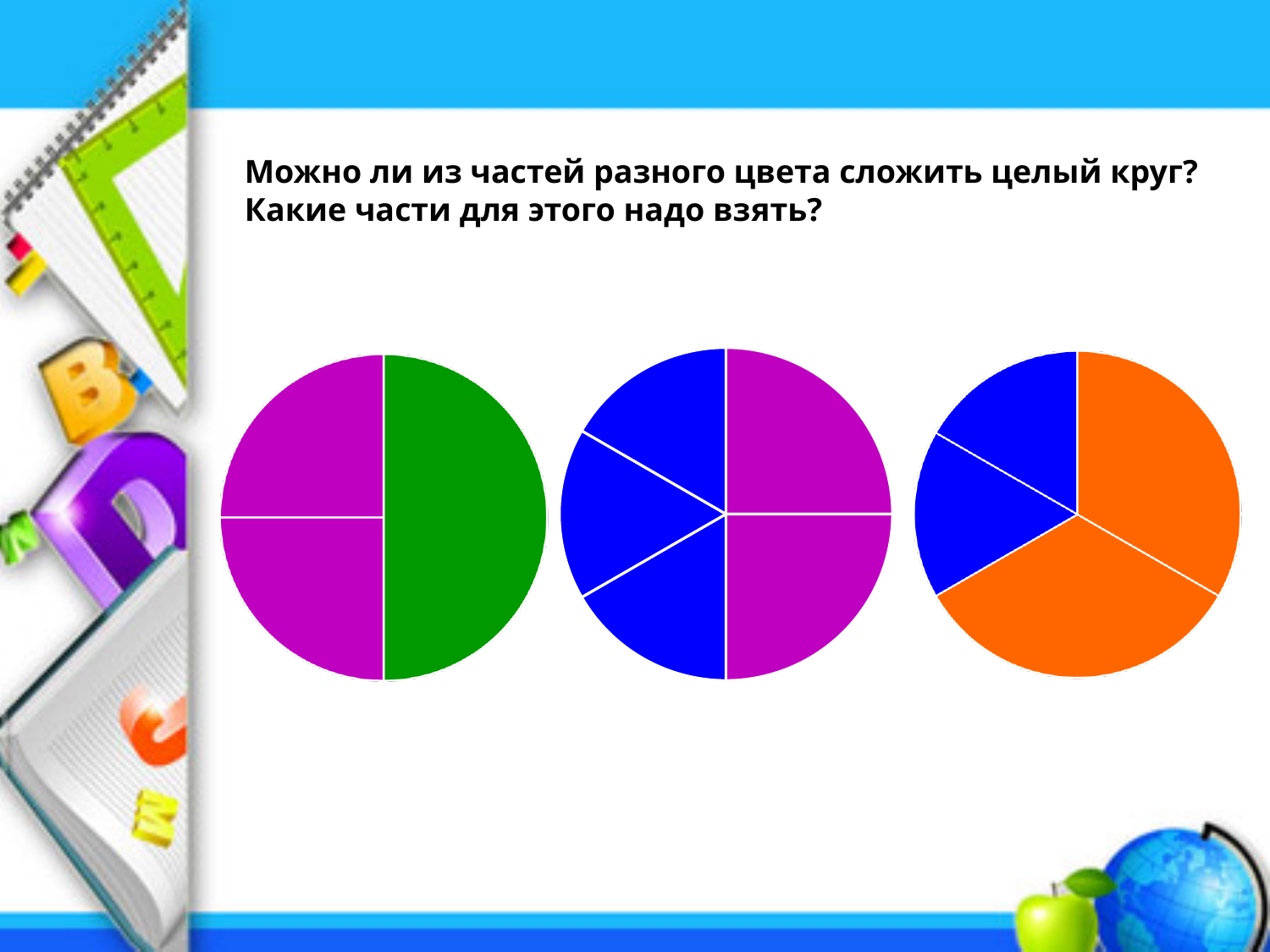
What two colours are used in the leftmost chart? purple and green In the middle chart, how many blue parts are there? 3 In the middle chart, how many parts is the circle divided into? 5 In the rightmost chart, which colour covers the larger area, blue or orange? orange In the rightmost chart, how many parts is the circle divided into? 4 What kind of chart is the leftmost chart on the slide? pie chart What two colours are used in the rightmost chart? blue and orange In the leftmost chart, which is larger, the green part or a single purple part? the green part